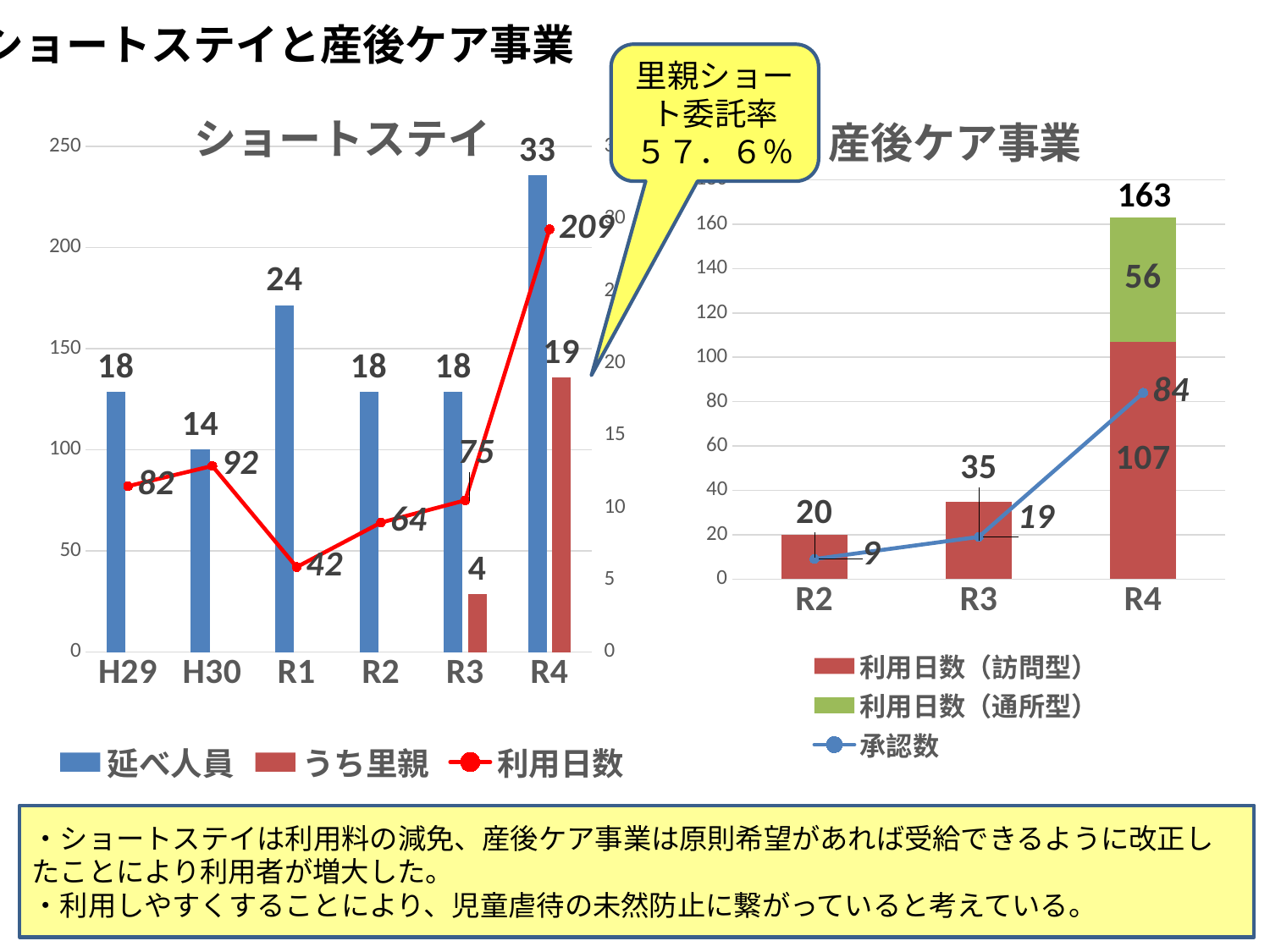
In the ショートステイ chart, which is larger, the 延べ人員 for H30 or for R1? R1 In the ショートステイ chart, what is the うち里親 value for R4? 19 In the ショートステイ chart, what is the difference in 利用日数 between R4 and R3? 134 In the ショートステイ chart, which year has the highest 延べ人員? R4 In the ショートステイ chart, what is the 利用日数 value for R4? 209 In the 産後ケア事業 chart, does the 承認数 line rise or fall from R2 to R4? rises How many years are shown on the x axis of the ショートステイ chart? 6 In the ショートステイ chart, which year has the lowest 利用日数? R1 In the ショートステイ chart, what is the 延べ人員 value for R1? 24 In the 産後ケア事業 chart, what is the total of the stacked bar for R4? 163 How many series does the legend of the ショートステイ chart list? 3 In the 産後ケア事業 chart, what is the 承認数 value for R4? 84